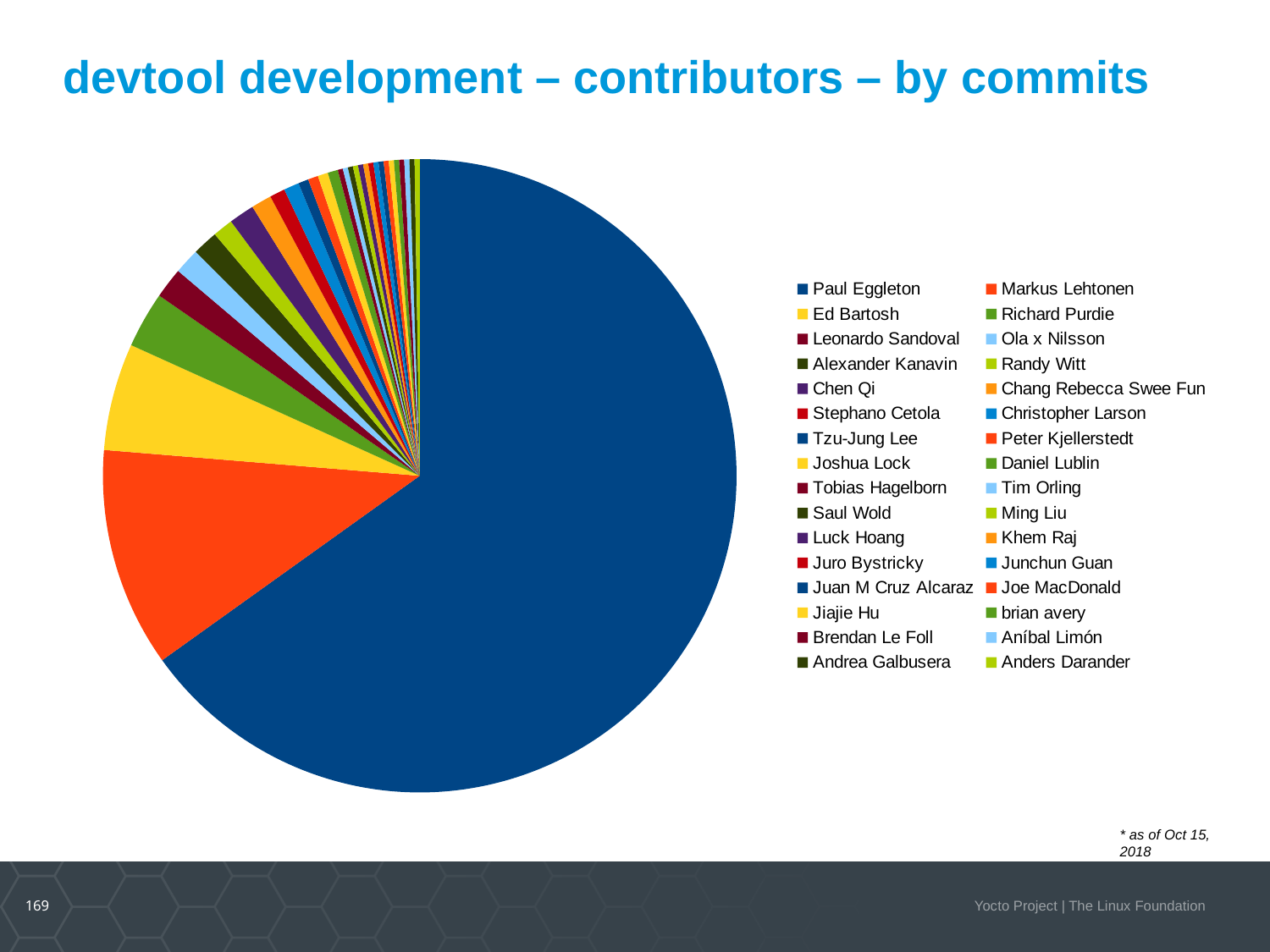
How many contributors are listed in the legend? 32 Which contributor has the largest slice of the pie? Paul Eggleton Which slice is larger, Paul Eggleton's or Markus Lehtonen's? Paul Eggleton Which slice is larger, Markus Lehtonen's or Ed Bartosh's? Markus Lehtonen What kind of chart is shown on the slide? pie chart What colour is the largest slice of the pie? dark blue Which contributor has the second-largest slice of the pie? Markus Lehtonen What is the title of the slide? devtool development – contributors – by commits Which slice is larger, Ed Bartosh's or Richard Purdie's? Ed Bartosh Does Paul Eggleton's slice account for more or less than half of the pie? more